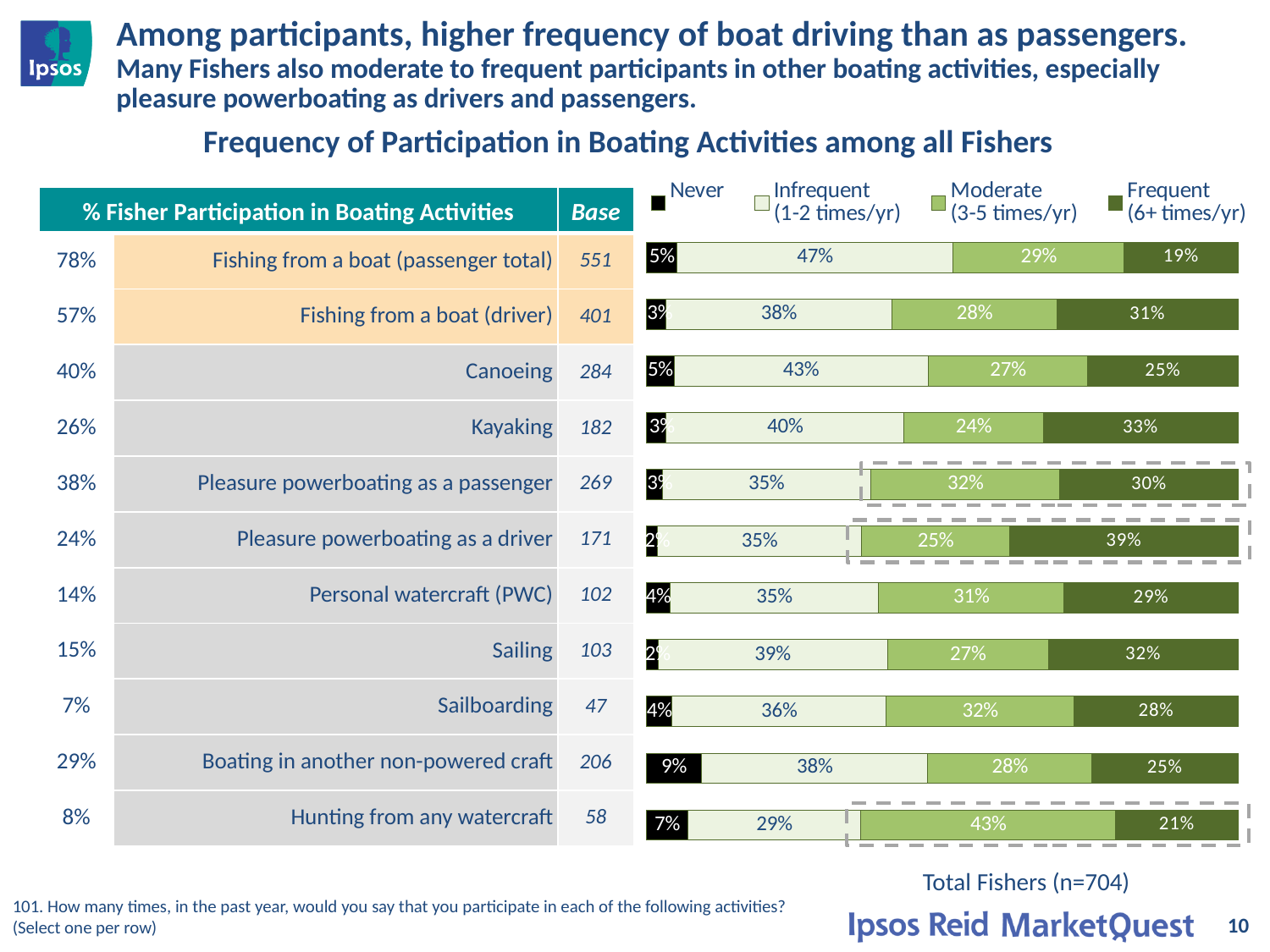
Which activity has the highest Frequent (6+ times/yr) value? Pleasure powerboating as a driver Which is larger: the Moderate value for Kayaking or the Moderate value for Canoeing? Canoeing What type of chart is shown on the slide? Stacked bar chart What is the Frequent (6+ times/yr) value for Pleasure powerboating as a driver? 39% What is the difference between the Frequent values for Fishing from a boat (driver) and Fishing from a boat (passenger total)? 12 percentage points Which activity has the lowest Frequent (6+ times/yr) value? Fishing from a boat (passenger total) How many boating activities are plotted in the chart? 11 Which activity has the highest Never value? Boating in another non-powered craft What is the base (n) shown for Sailboarding? 47 What is the Infrequent (1-2 times/yr) value for Fishing from a boat (passenger total)? 47% How many series does the chart legend list? 4 What is the Moderate (3-5 times/yr) value for Hunting from any watercraft? 43%